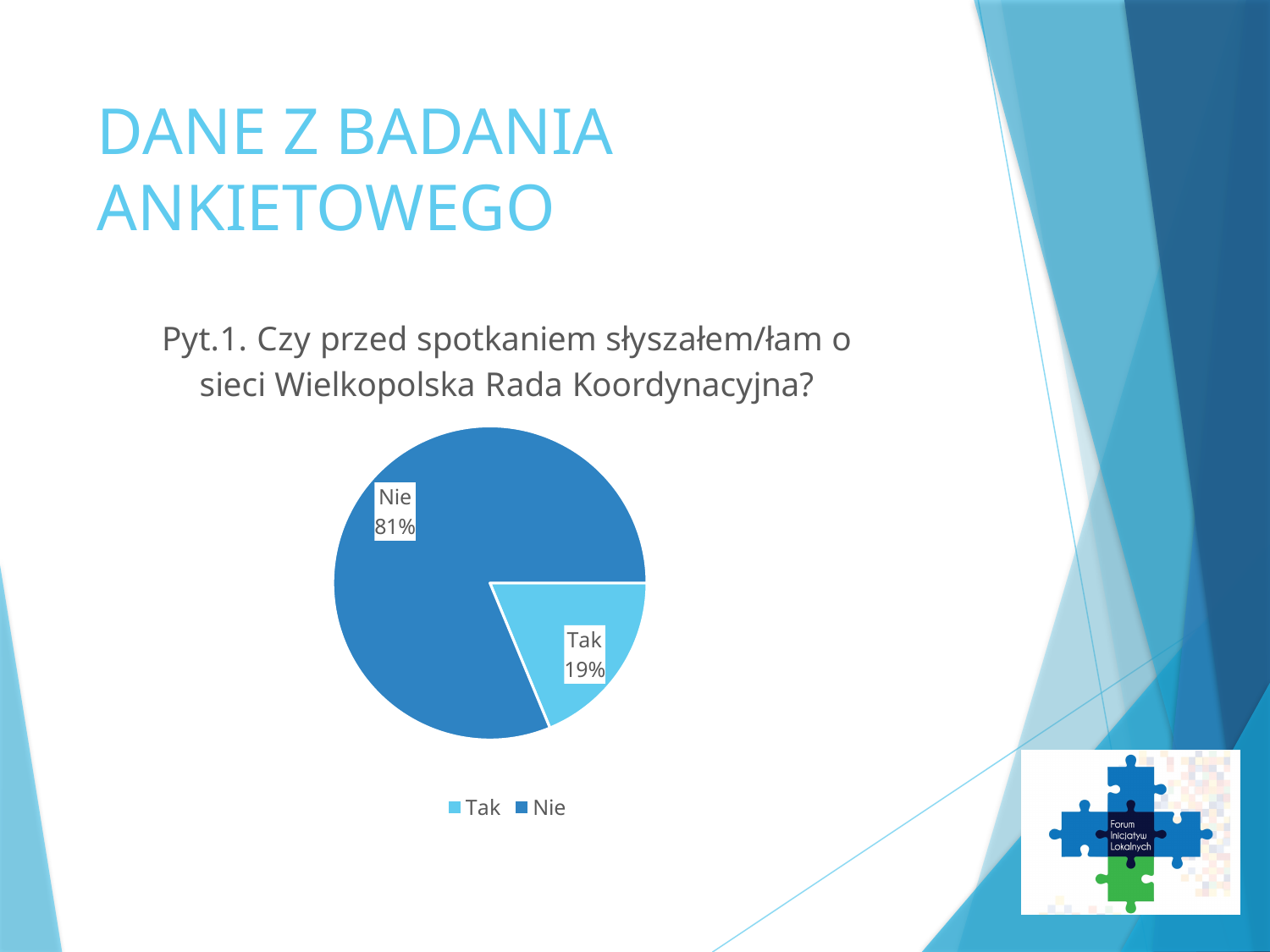
What percentage of respondents answered "Tak"? 19% Which answer has the largest share of the pie? Nie Which slice is larger, "Tak" or "Nie"? Nie How many slices does the pie chart have? 2 Which answer has the smallest share of the pie? Tak What is the share of the pie taken by the "Tak" slice? 19% What kind of chart is shown on the slide? pie chart How many entries does the legend list? 2 What is the title of the chart? Pyt.1. Czy przed spotkaniem słyszałem/łam o sieci Wielkopolska Rada Koordynacyjna? What percentage of respondents answered "Nie"? 81% What is the difference in percentage points between the "Nie" and "Tak" slices? 62 Which legend entry is shown in the lighter blue colour? Tak